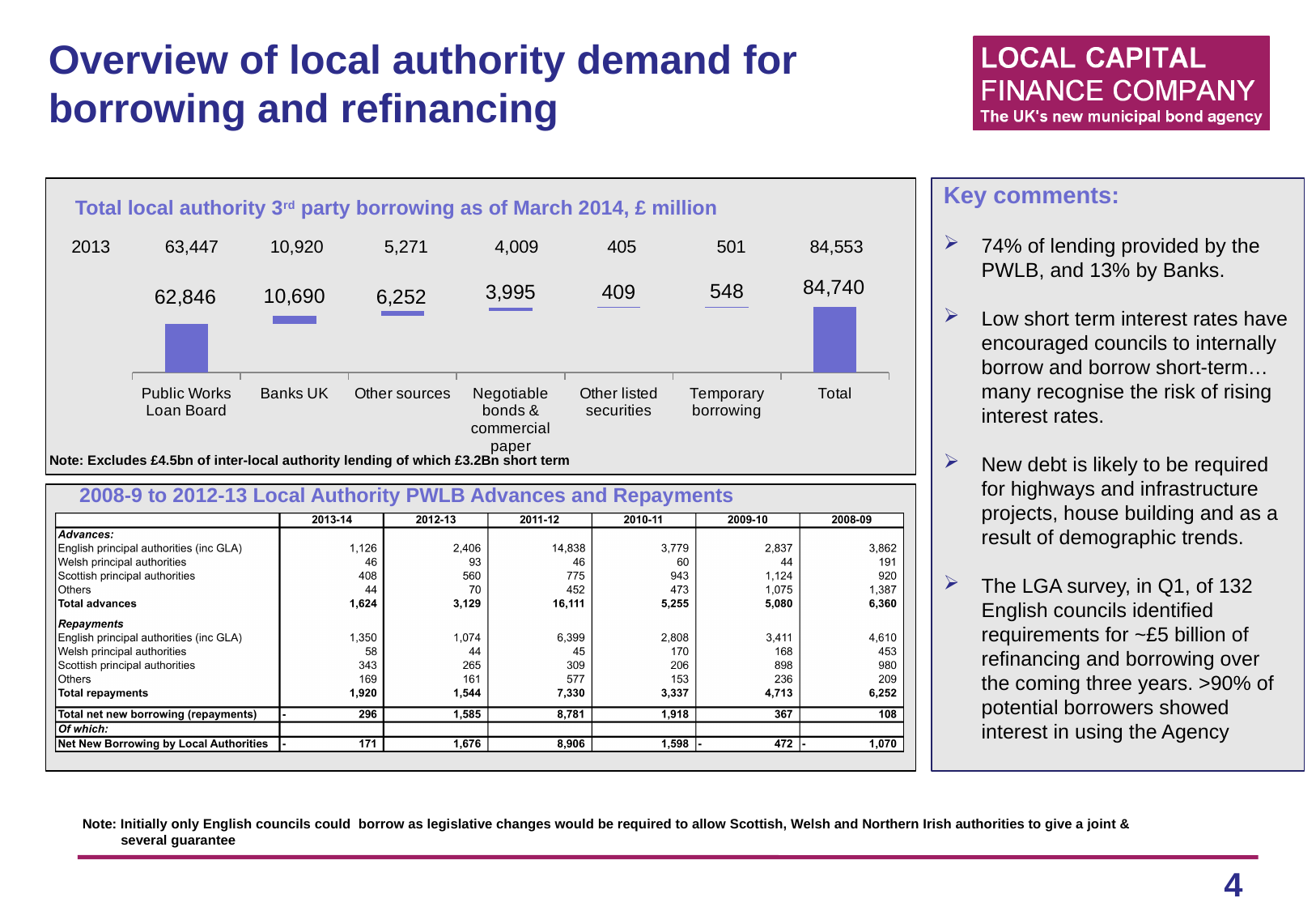
In the chart 'Total local authority 3rd party borrowing as of March 2014, £ million', what is the value for Temporary borrowing? 548 In the chart 'Total local authority 3rd party borrowing as of March 2014, £ million', which category has the lowest value? Other listed securities How many categories are shown along the x axis of the chart 'Total local authority 3rd party borrowing as of March 2014, £ million'? 7 In the chart 'Total local authority 3rd party borrowing as of March 2014, £ million', what is the difference between the Public Works Loan Board value and the Banks UK value? 52,156 In the chart 'Total local authority 3rd party borrowing as of March 2014, £ million', which is larger: Other sources or Negotiable bonds & commercial paper? Other sources In the chart 'Total local authority 3rd party borrowing as of March 2014, £ million', excluding the Total bar, which category has the highest value? Public Works Loan Board In the chart 'Total local authority 3rd party borrowing as of March 2014, £ million', what is the value for Public Works Loan Board? 62,846 In the chart 'Total local authority 3rd party borrowing as of March 2014, £ million', what is the value for Negotiable bonds & commercial paper? 3,995 In the chart 'Total local authority 3rd party borrowing as of March 2014, £ million', what is the value for Banks UK? 10,690 In the chart 'Total local authority 3rd party borrowing as of March 2014, £ million', what is the value shown for Total? 84,740 In the chart 'Total local authority 3rd party borrowing as of March 2014, £ million', what is the value for Other sources? 6,252 What kind of chart is 'Total local authority 3rd party borrowing as of March 2014, £ million'? Bar chart